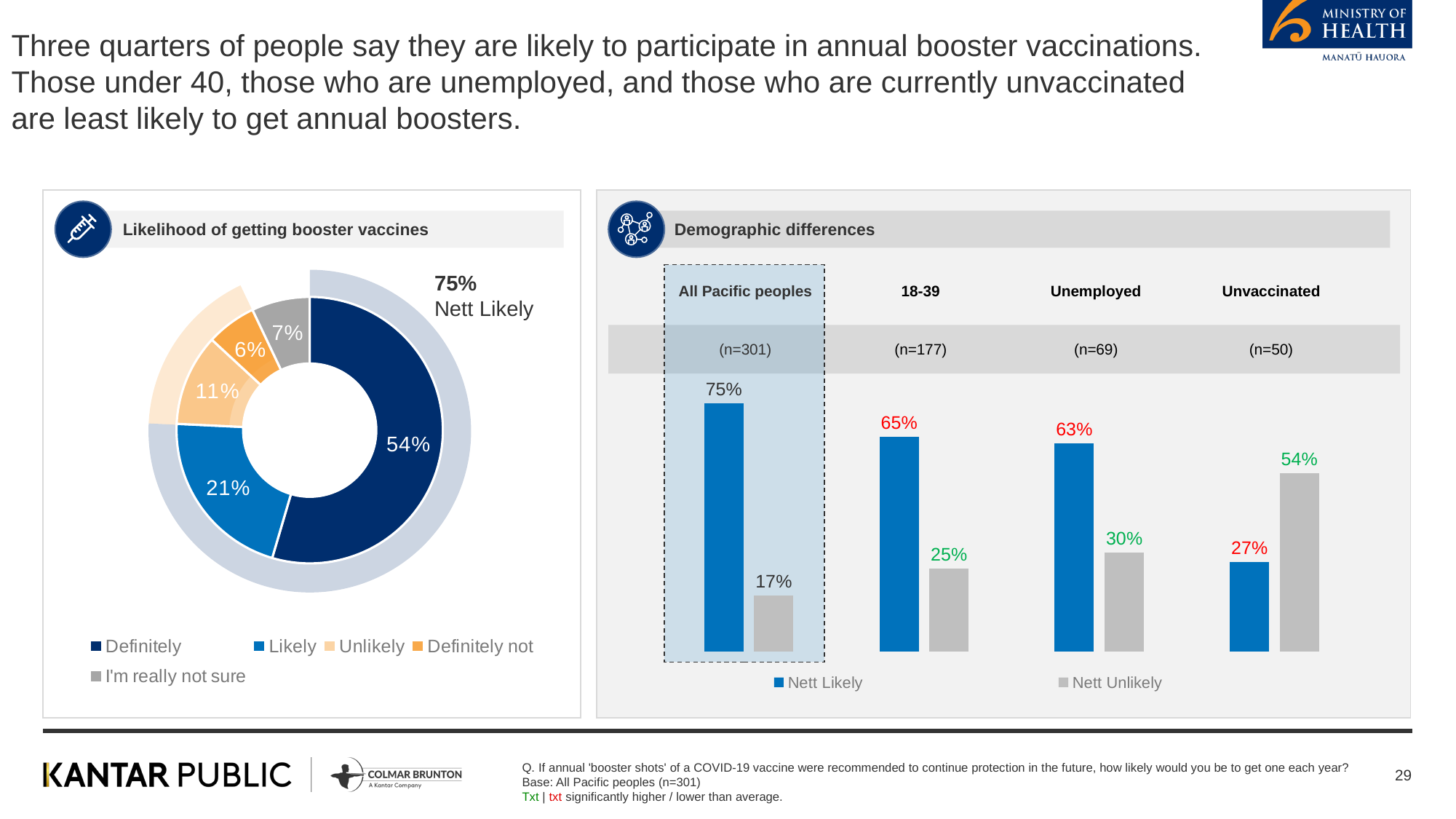
In the 'Demographic differences' chart, is the Nett Unlikely value for 18-39 larger or smaller than the Nett Unlikely value for Unemployed? Smaller How many categories does the legend of the 'Likelihood of getting booster vaccines' chart list? 5 In the 'Demographic differences' chart, what is the Nett Unlikely value for the Unvaccinated group? 54% In the 'Demographic differences' chart, what is the Nett Likely value for the Unemployed group? 63% In the 'Demographic differences' chart, which group has the lowest Nett Likely value? Unvaccinated In the 'Likelihood of getting booster vaccines' chart, what percentage of people said 'Likely'? 21% How many series does the legend of the 'Demographic differences' chart list? 2 In the 'Demographic differences' chart, what is the difference between the Nett Likely values for All Pacific peoples and 18-39? 10% In the 'Likelihood of getting booster vaccines' chart, what percentage of people said 'Definitely'? 54% In the 'Likelihood of getting booster vaccines' chart, what is the difference between the 'Unlikely' and 'Definitely not' shares? 5% In the 'Likelihood of getting booster vaccines' chart, which response has the smallest share? Definitely not What kind of chart is the 'Likelihood of getting booster vaccines' chart? Doughnut chart